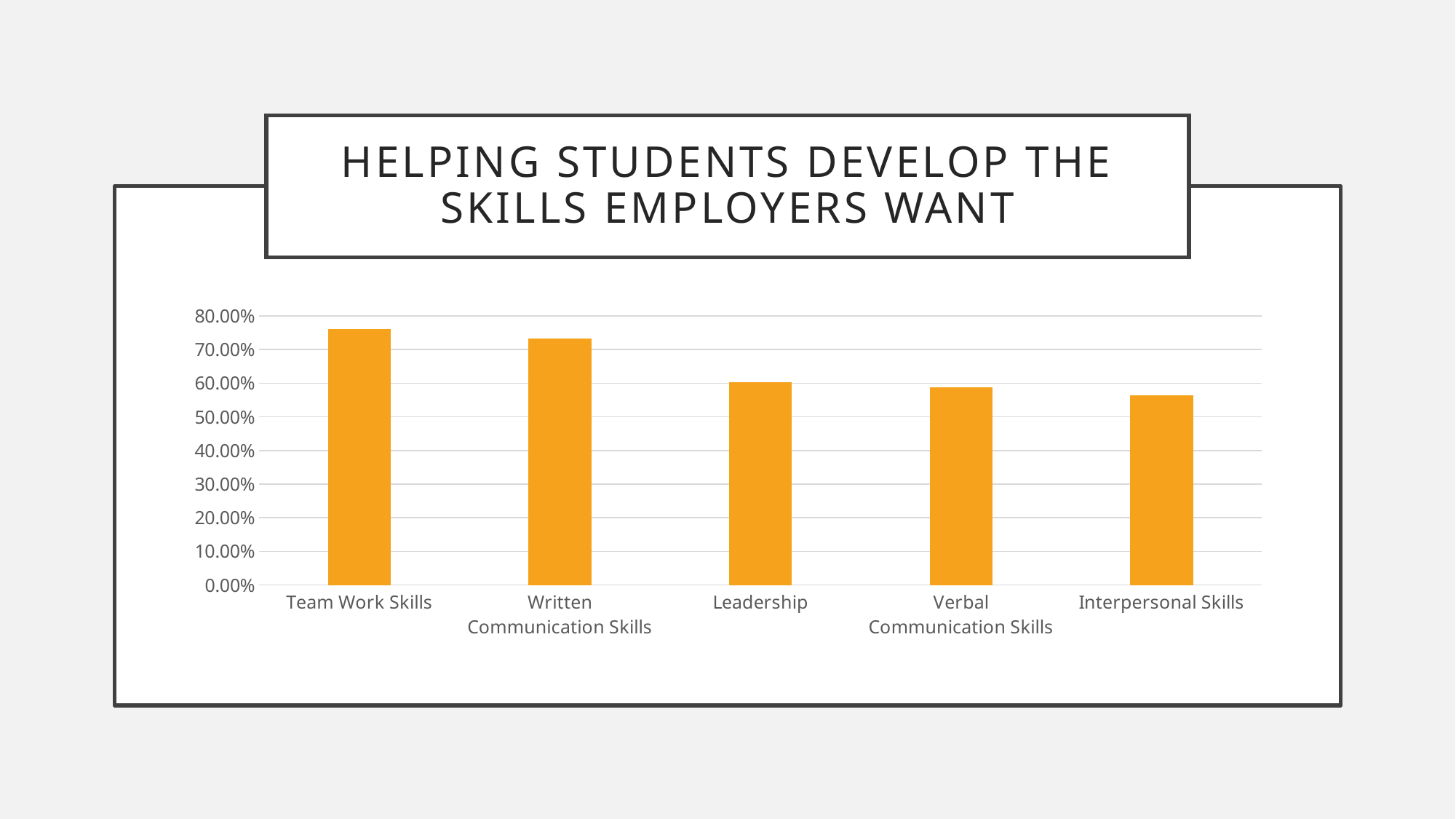
What is the title shown above the chart? HELPING STUDENTS DEVELOP THE SKILLS EMPLOYERS WANT Is the value for Team Work Skills greater or less than 70.00%? greater How many skill categories are shown on the chart? 5 What kind of chart is shown on the slide? bar chart Is the value for Written Communication Skills greater or less than 70.00%? greater Is the value for Interpersonal Skills greater or less than 50.00%? greater Which skill has the highest value on the chart? Team Work Skills Which skill has the lowest value on the chart? Interpersonal Skills Which is larger, the value for Team Work Skills or the value for Leadership? Team Work Skills Do the values rise or fall moving from left to right across the categories? fall